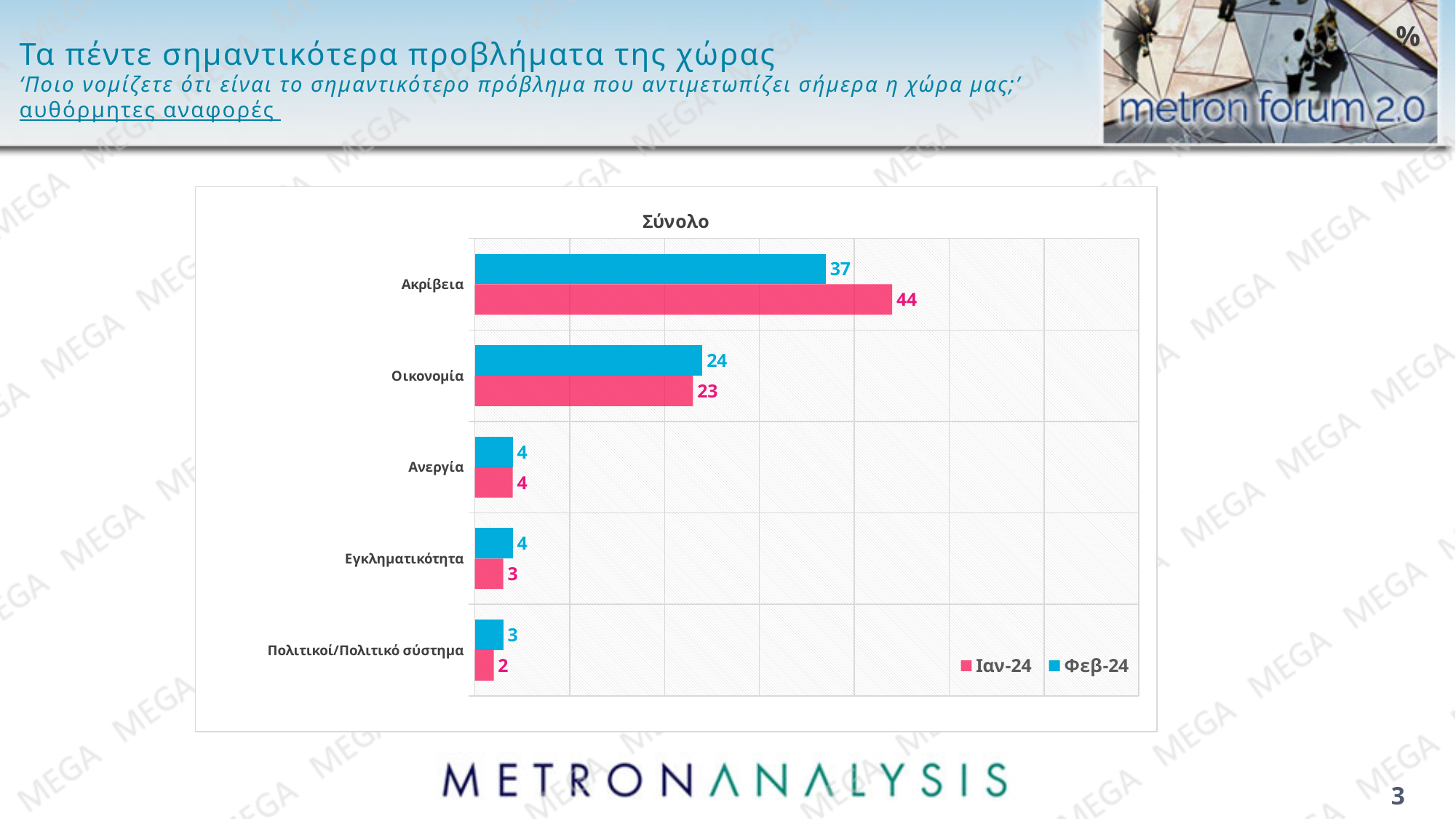
Which category has the highest value in the Ιαν-24 series? Ακρίβεια What is the value for Ακρίβεια in the Ιαν-24 series? 44 How many categories are shown in the chart? 5 How many series does the legend list? 2 For Οικονομία, which series has the larger value, Ιαν-24 or Φεβ-24? Φεβ-24 What is the value for Οικονομία in the Φεβ-24 series? 24 What kind of chart is shown on the slide? Bar chart What is the title of the chart? Σύνολο What is the value for Ακρίβεια in the Φεβ-24 series? 37 What is the difference between the Ιαν-24 and Φεβ-24 values for Ακρίβεια? 7 Which category has the lowest value in the Φεβ-24 series? Πολιτικοί/Πολιτικό σύστημα What is the value for Πολιτικοί/Πολιτικό σύστημα in the Ιαν-24 series? 2